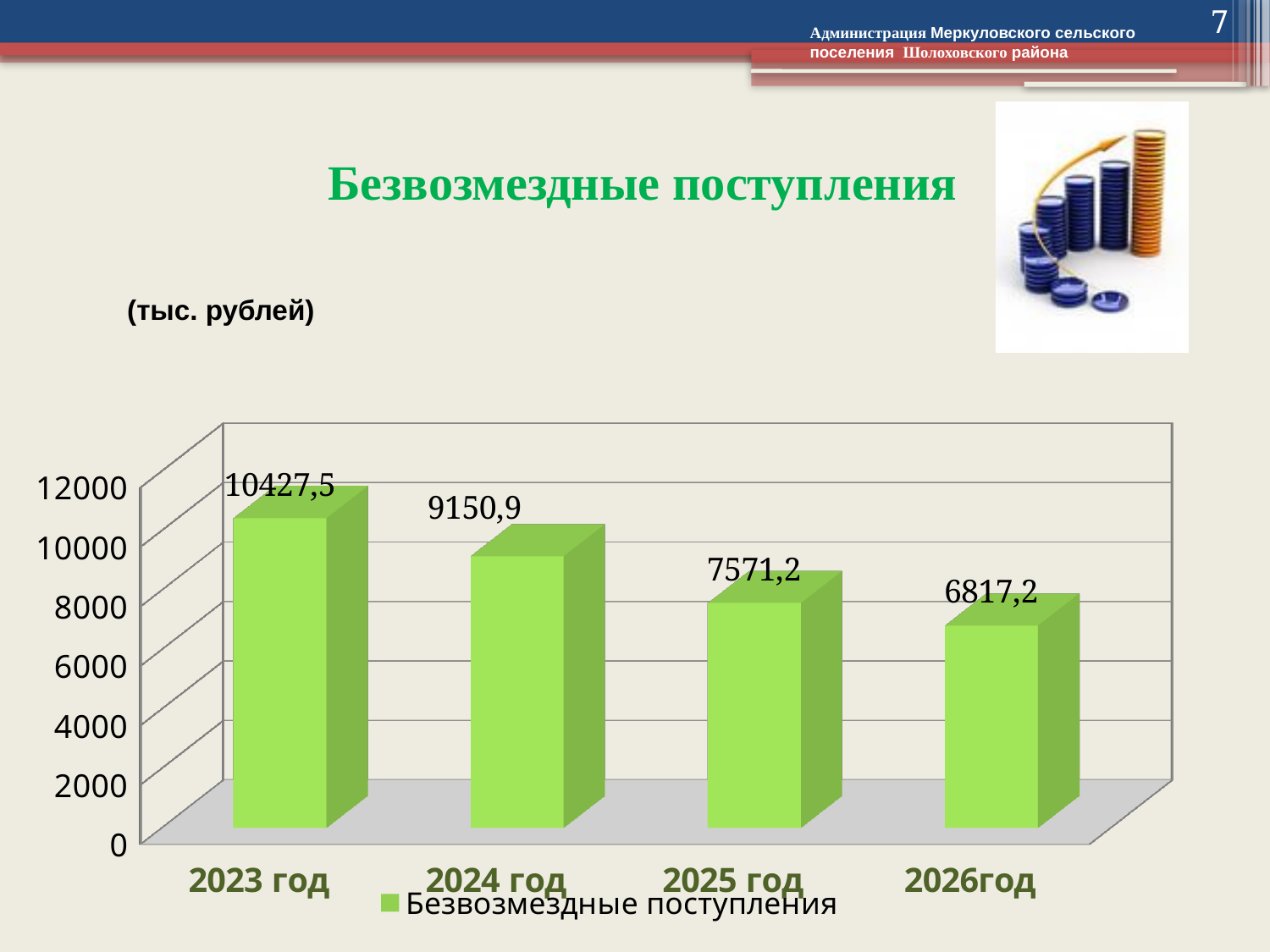
Do the values rise or fall from 2023 год to 2026год? fall Which is larger, the value for 2024 год or the value for 2025 год? 2024 год Which year has the lowest value? 2026год What is the value for 2025 год? 7571,2 What is the value for 2026год? 6817,2 How many years are shown on the chart? 4 What is the difference between the values for 2023 год and 2024 год? 1276,6 Which year has the highest value? 2023 год What is the value for 2023 год? 10427,5 What is the value for 2024 год? 9150,9 What kind of chart is shown on the slide? bar chart What is the difference between the values for 2023 год and 2026год? 3610,3